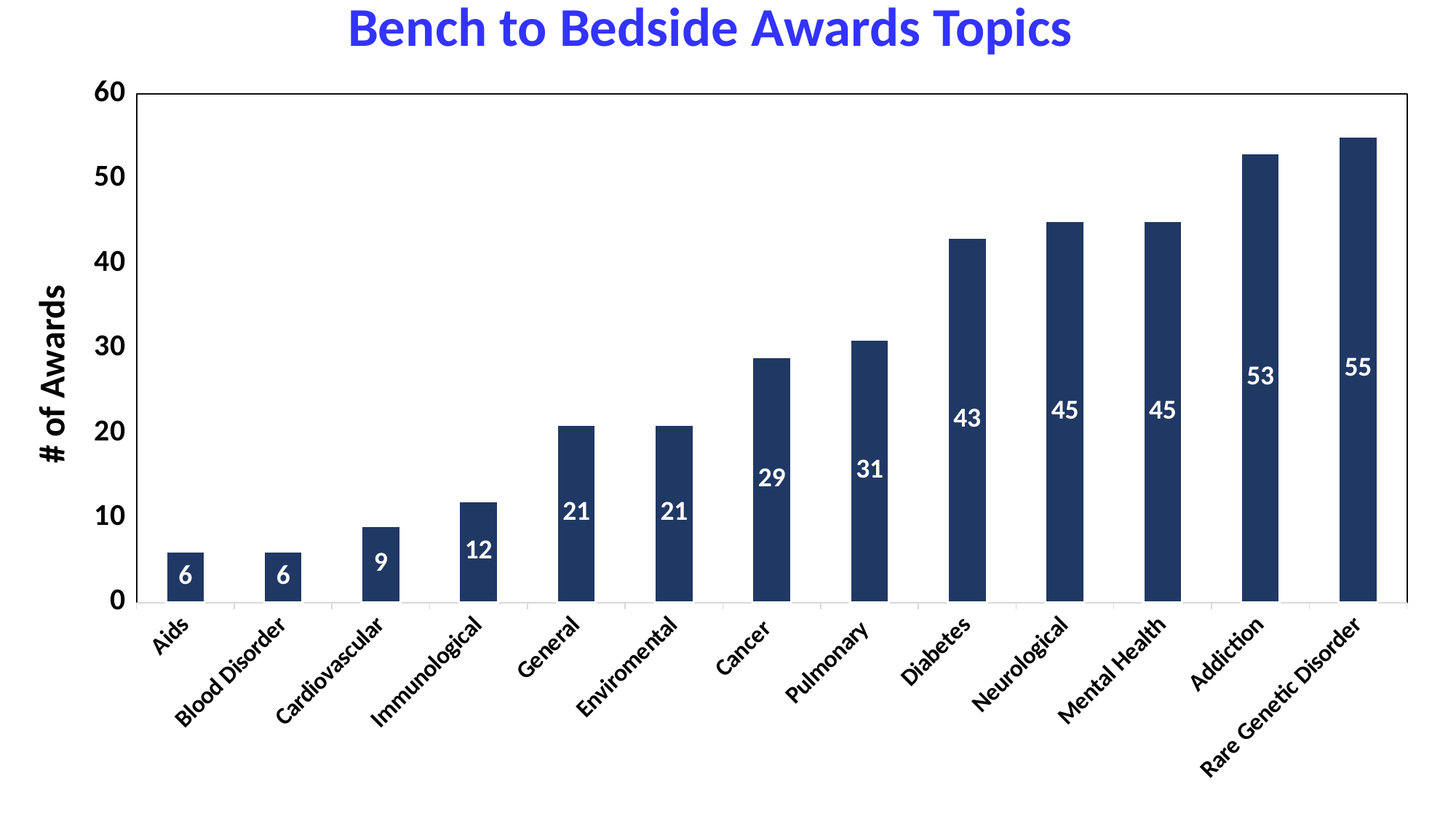
What is the title of the chart? Bench to Bedside Awards Topics What kind of chart is this? bar chart How many topics are shown on the x axis? 13 What is the difference in awards between Pulmonary and Cancer? 2 What is the number of awards for Immunological? 12 What is the number of awards for Addiction? 53 Which topic has the fewest awards, Cardiovascular or Immunological? Cardiovascular What is the difference in awards between Rare Genetic Disorder and Diabetes? 12 Do the values rise or fall from left to right along the x axis? rise How many awards does the chart show for Cancer? 29 Is the value for Mental Health greater or less than 40? greater Which topic has the highest number of awards? Rare Genetic Disorder